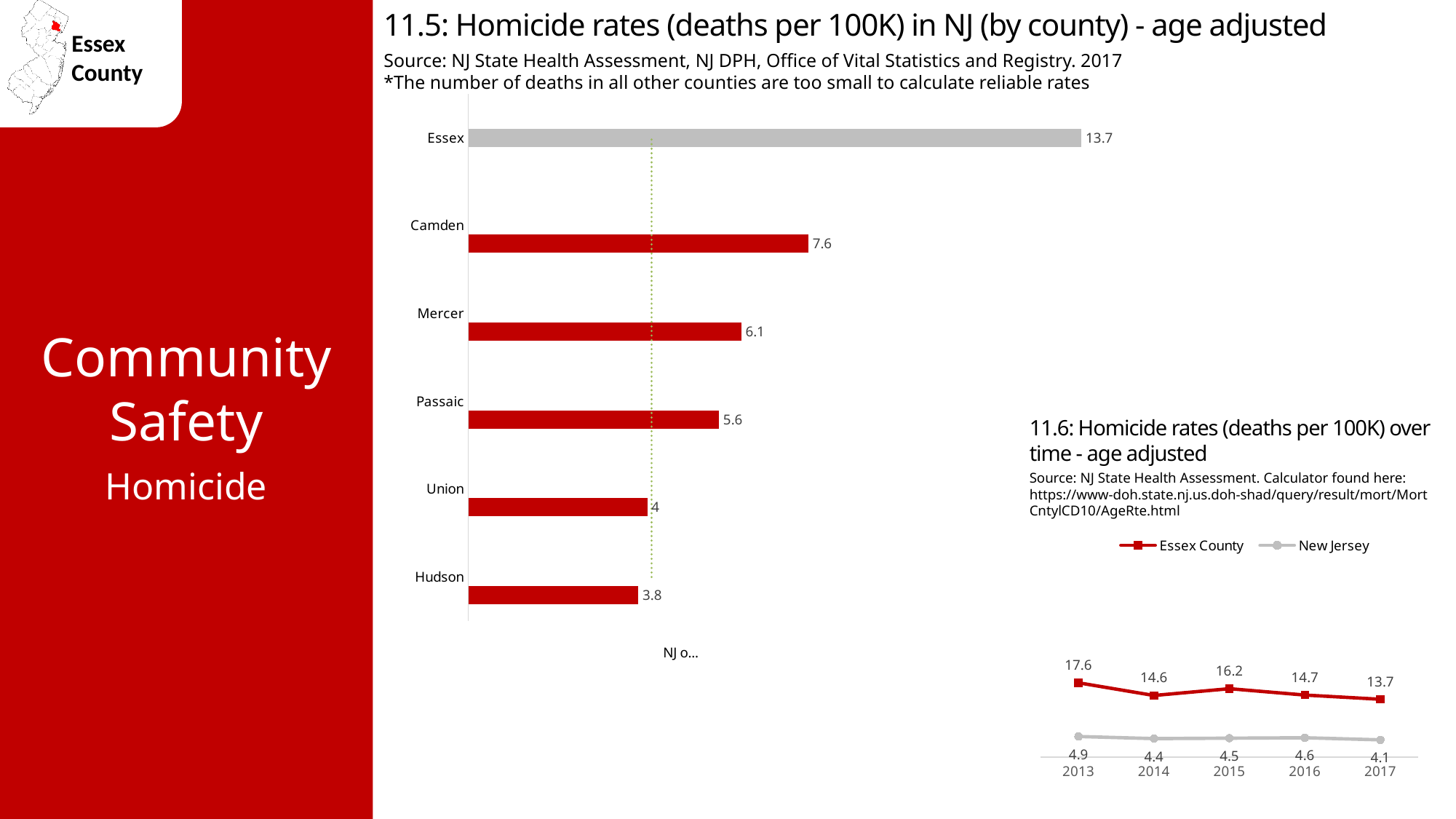
In chart 11.5 (homicide rates by county), what is the homicide rate for Camden? 7.6 In chart 11.6 (homicide rates over time), what was the Essex County rate in 2013? 17.6 In chart 11.5 (homicide rates by county), which county has the lowest homicide rate? Hudson In chart 11.5 (homicide rates by county), what is the difference between the Essex and Camden rates? 6.1 In chart 11.6 (homicide rates over time), how many series does the legend list? 2 In chart 11.5 (homicide rates by county), how many counties are shown? 6 In chart 11.5 (homicide rates by county), what kind of chart is used? Bar chart In chart 11.5 (homicide rates by county), which county has the highest homicide rate? Essex In chart 11.6 (homicide rates over time), what was the New Jersey rate in 2017? 4.1 In chart 11.6 (homicide rates over time), which year had the highest Essex County rate? 2013 In chart 11.6 (homicide rates over time), what is the difference between the Essex County and New Jersey rates in 2015? 11.7 In chart 11.5 (homicide rates by county), what is the homicide rate for Essex? 13.7